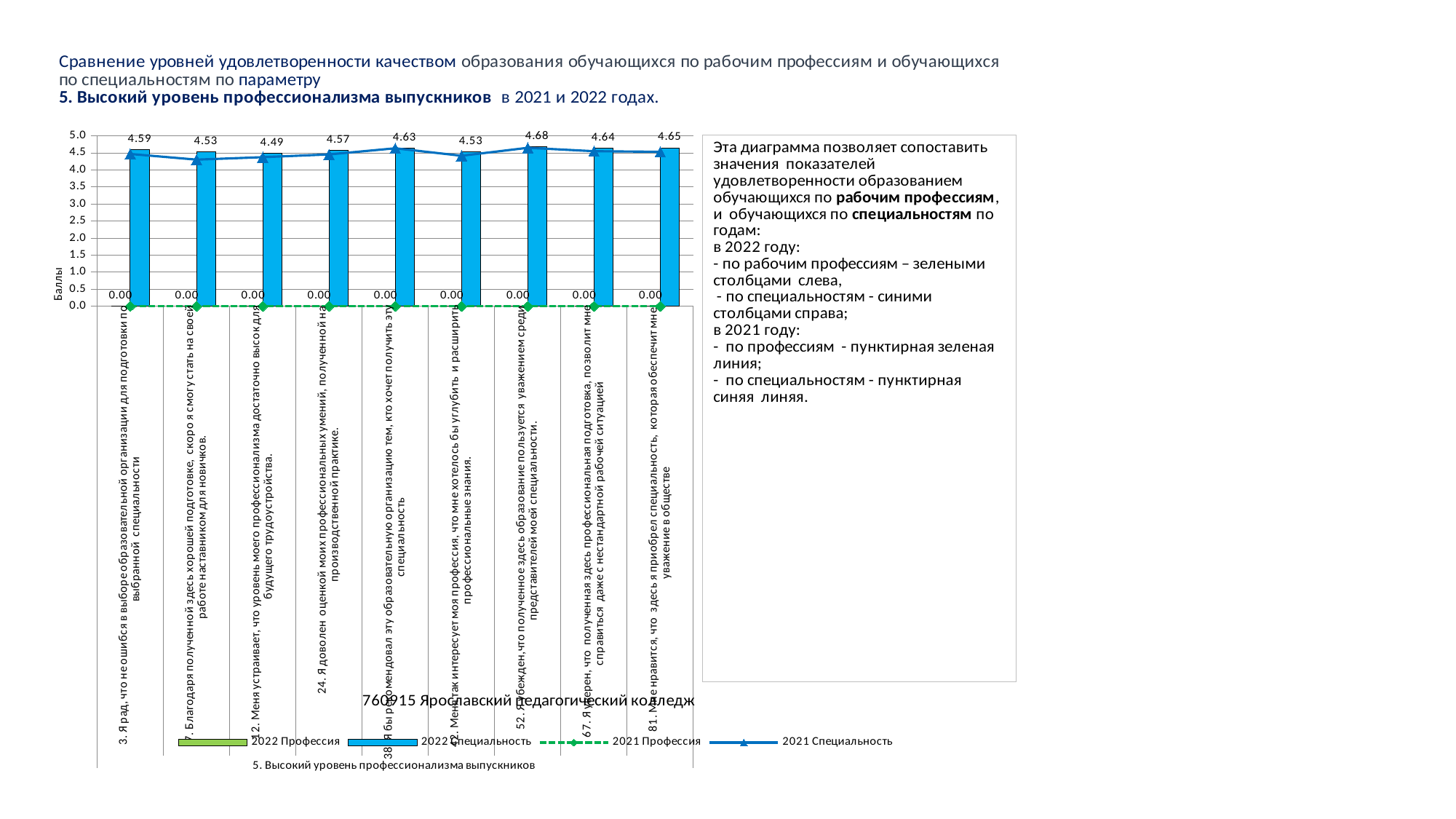
What is the value of the 2022 Специальность bar for category 3 (Я рад, что не ошибся в выборе образовательной организации)? 4.59 What is the label of the vertical axis? Баллы What is the value of the 2022 Специальность bar for category 52 (Я убежден, что полученное здесь образование пользуется уважением)? 4.68 What is the difference between the highest (4.68) and lowest (4.49) 2022 Специальность values? 0.19 What is the value of the 2022 Профессия series for category 3? 0.00 Which has a larger 2022 Специальность value: category 24 or category 38? Category 38 (4.63) Is the 2021 Специальность line value for category 7 greater or less than 4.5? less How many categories (statements) are shown on the x axis? 9 Which category has the lowest 2022 Специальность value? 12. Меня устраивает, что уровень моего профессионализма достаточно высок для будущего трудоустройства How many series does the legend list? 4 Which category has the highest 2022 Специальность value? 52. Я убежден, что полученное здесь образование пользуется уважением среди представителей моей специальности What kind of chart is shown on the slide? Bar chart (with line series)